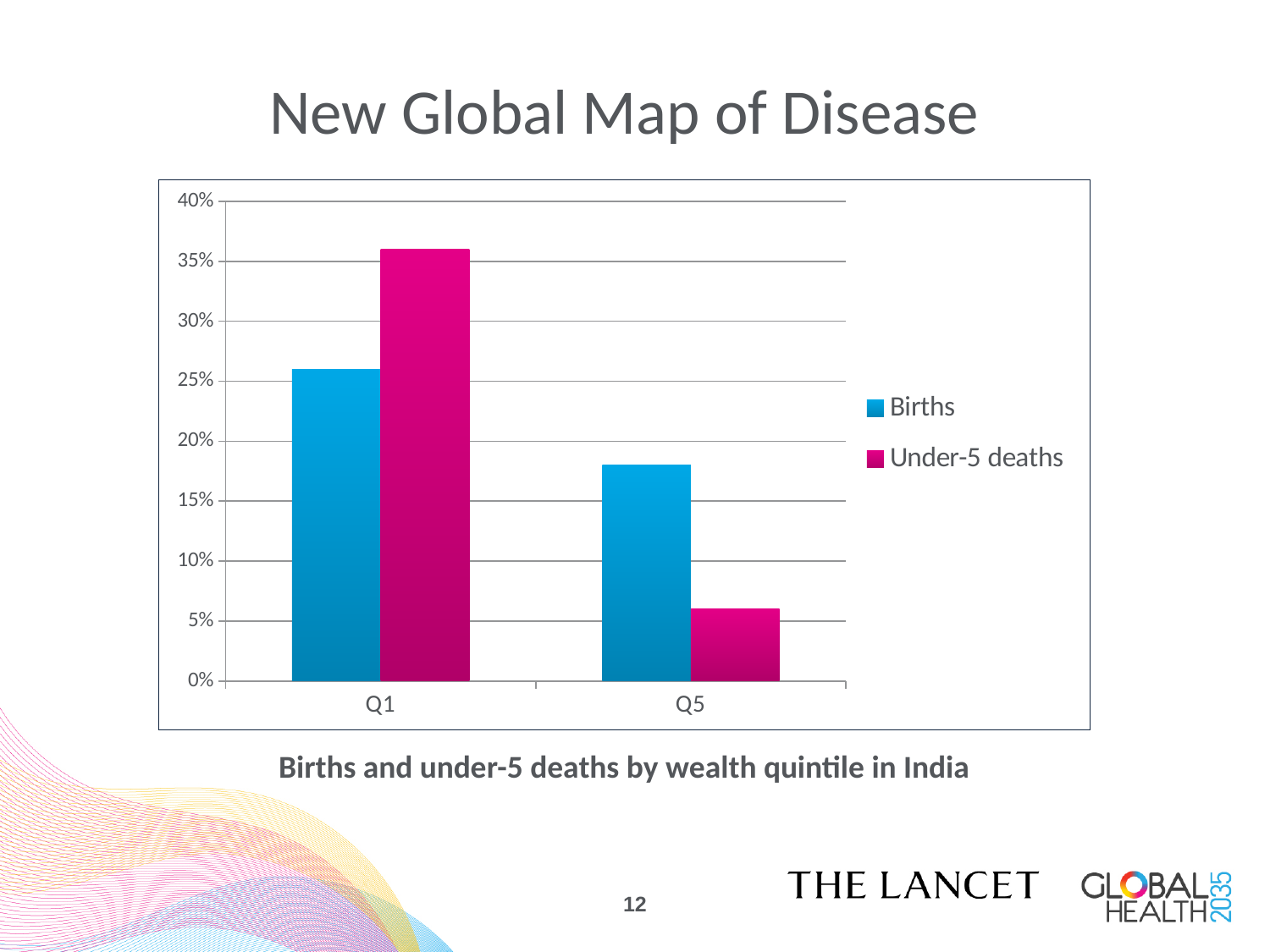
What kind of chart is shown on the slide? bar chart Is the value for Under-5 deaths in Q5 greater or less than 10%? less Which is larger in Q5, Births or Under-5 deaths? Births Which is larger in Q1, Births or Under-5 deaths? Under-5 deaths Which quintile has the higher share of Under-5 deaths, Q1 or Q5? Q1 Which series are listed in the legend? Births and Under-5 deaths Is the value for Births in Q1 greater or less than 30%? less What is the caption below the chart? Births and under-5 deaths by wealth quintile in India Is the value for Births in Q5 greater or less than 15%? greater How many wealth quintile categories are shown on the x axis? 2 How many series does the legend list? 2